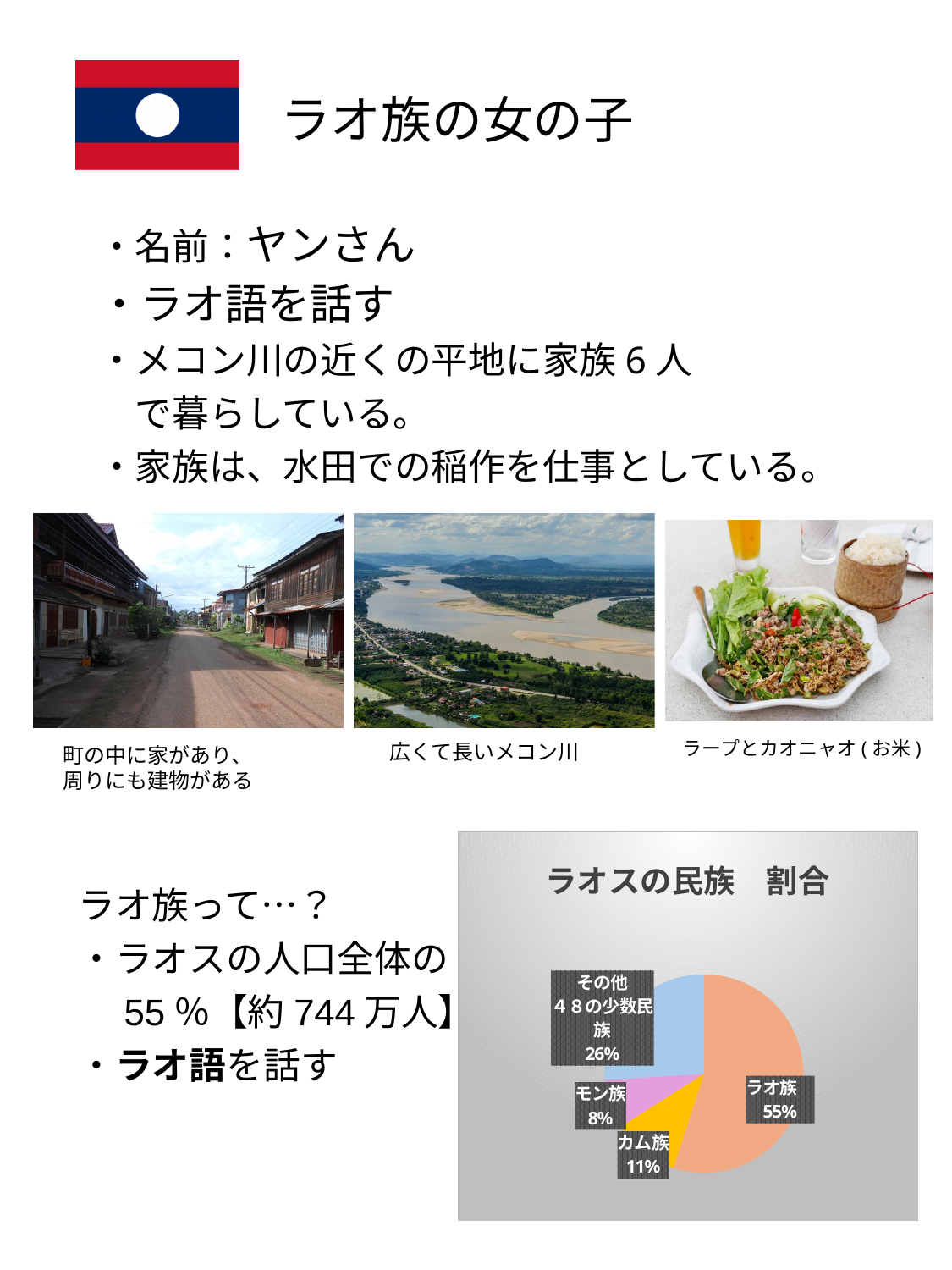
What share of the pie does モン族 have? 8% What share of the pie does その他48の少数民族 have? 26% What share of the pie does ラオ族 have? 55% How many slices does the pie chart have? 4 What is the difference between the shares of ラオ族 and その他48の少数民族? 29% Which slice of the pie is the largest? ラオ族 Which slice of the pie is the smallest? モン族 What is the title of the chart? ラオスの民族 割合 What is the difference between the shares of カム族 and モン族? 3% Which is larger, the share of カム族 or the share of モン族? カム族 What type of chart is shown on the slide? pie chart